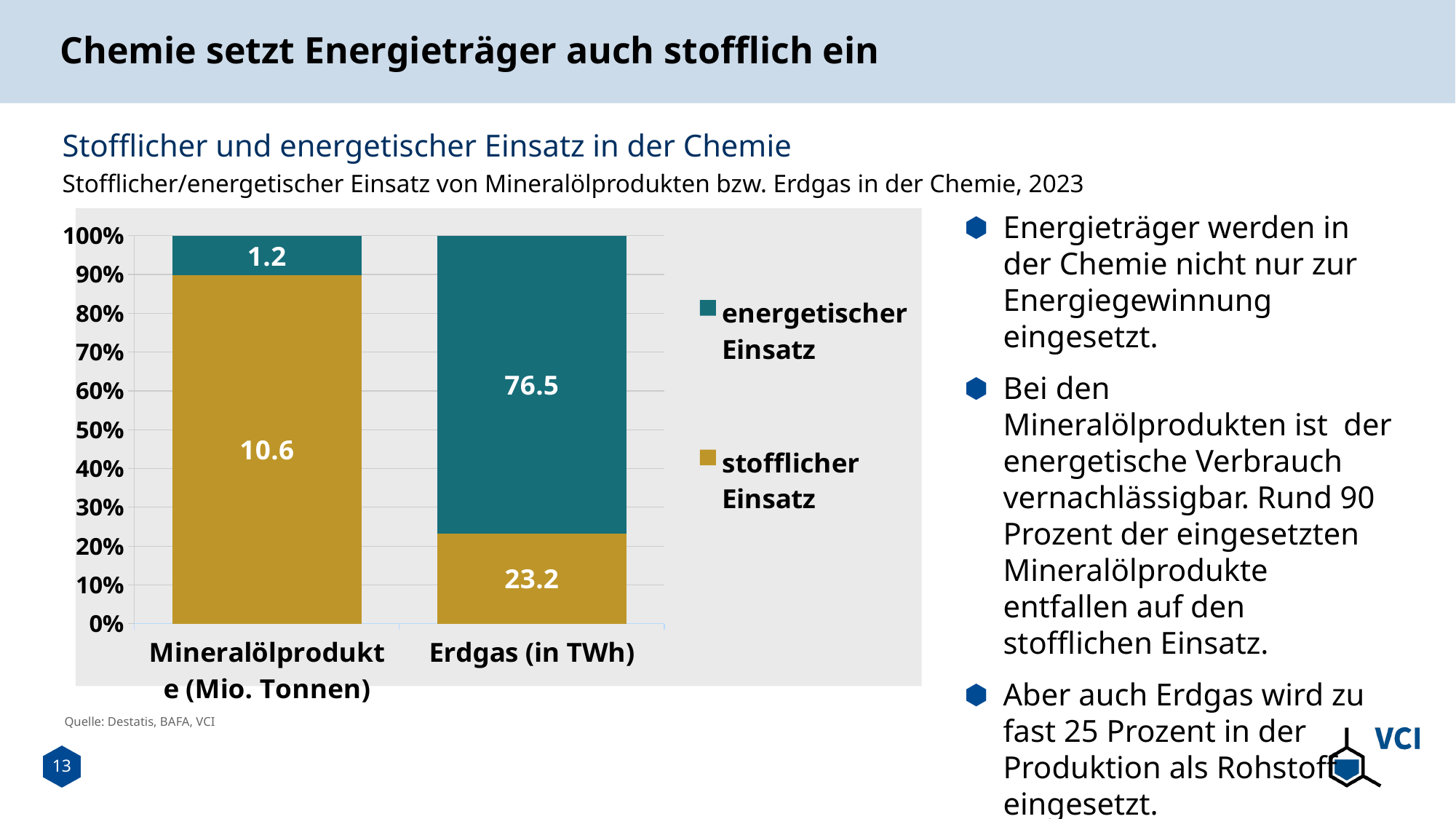
What is the value of stofflicher Einsatz for Mineralölprodukte (Mio. Tonnen)? 10.6 What is the value of energetischer Einsatz for Erdgas (in TWh)? 76.5 What is the value of stofflicher Einsatz for Erdgas (in TWh)? 23.2 What is the difference between energetischer Einsatz and stofflicher Einsatz for Erdgas (in TWh)? 53.3 For Erdgas (in TWh), which is larger: energetischer Einsatz or stofflicher Einsatz? energetischer Einsatz What is the value of energetischer Einsatz for Mineralölprodukte (Mio. Tonnen)? 1.2 What kind of chart is shown on the slide? stacked bar chart How many series does the legend list? 2 For Mineralölprodukte (Mio. Tonnen), which is larger: stofflicher Einsatz or energetischer Einsatz? stofflicher Einsatz What is the total of the two labelled values in the Erdgas (in TWh) bar? 99.7 Is the share of stofflicher Einsatz in the Erdgas (in TWh) bar greater or less than 30%? less What is the total of the two labelled values in the Mineralölprodukte (Mio. Tonnen) bar? 11.8